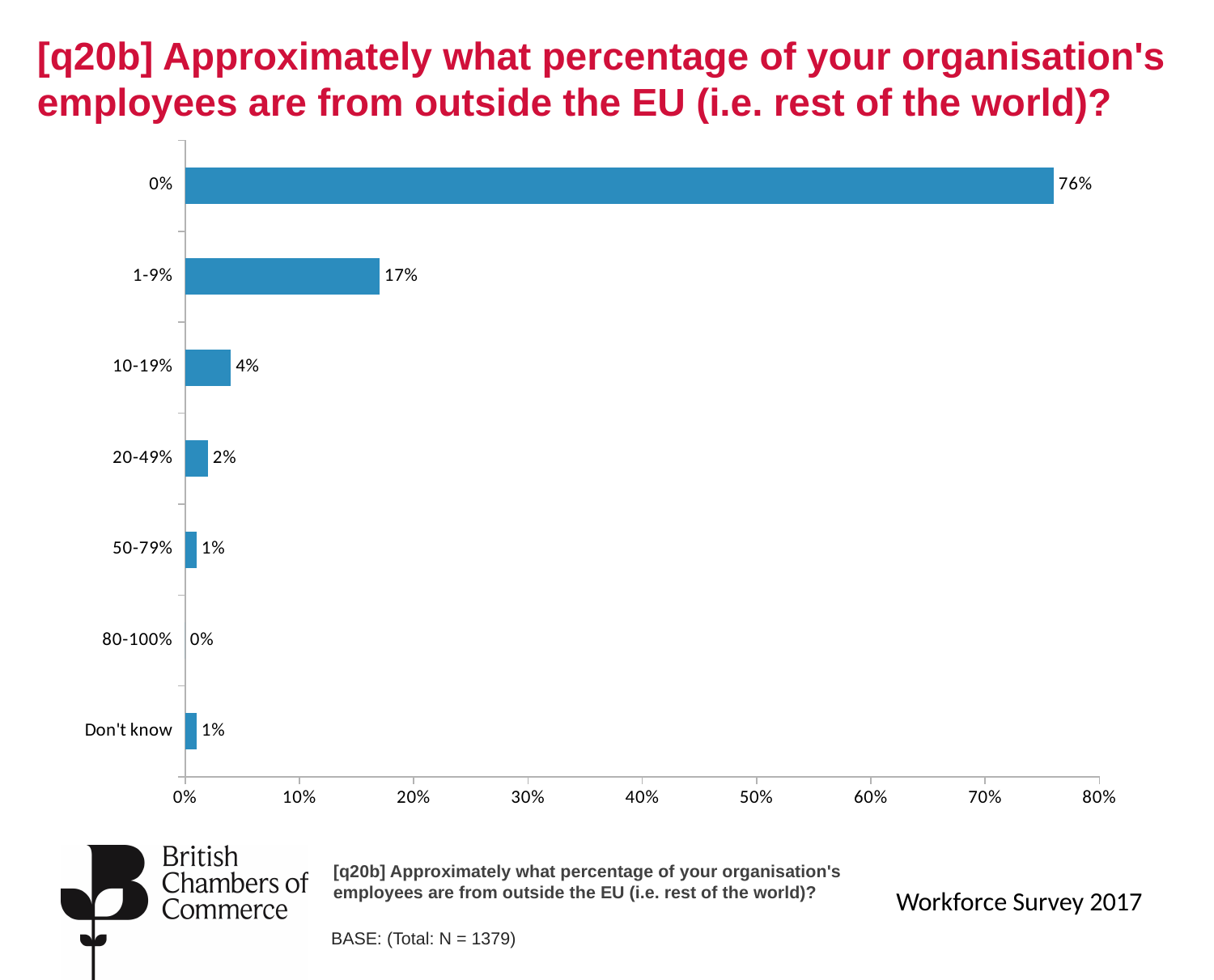
What is the value for the 10-19% category? 4% What is the value for the 1-9% category? 17% What is the value for the 80-100% category? 0% Which category has the highest value? 0% What is the base (sample size) stated for this chart? N = 1379 What kind of chart is shown on the slide? Bar chart How many categories are shown on the chart? 7 Which category has the lowest value? 80-100% What is the value for the 20-49% category? 2% Which is larger, the value for 10-19% or the value for 20-49%? 10-19% What percentage of respondents said 0% of their employees are from outside the EU? 76% What is the difference between the values for the 0% and 1-9% categories? 59 percentage points